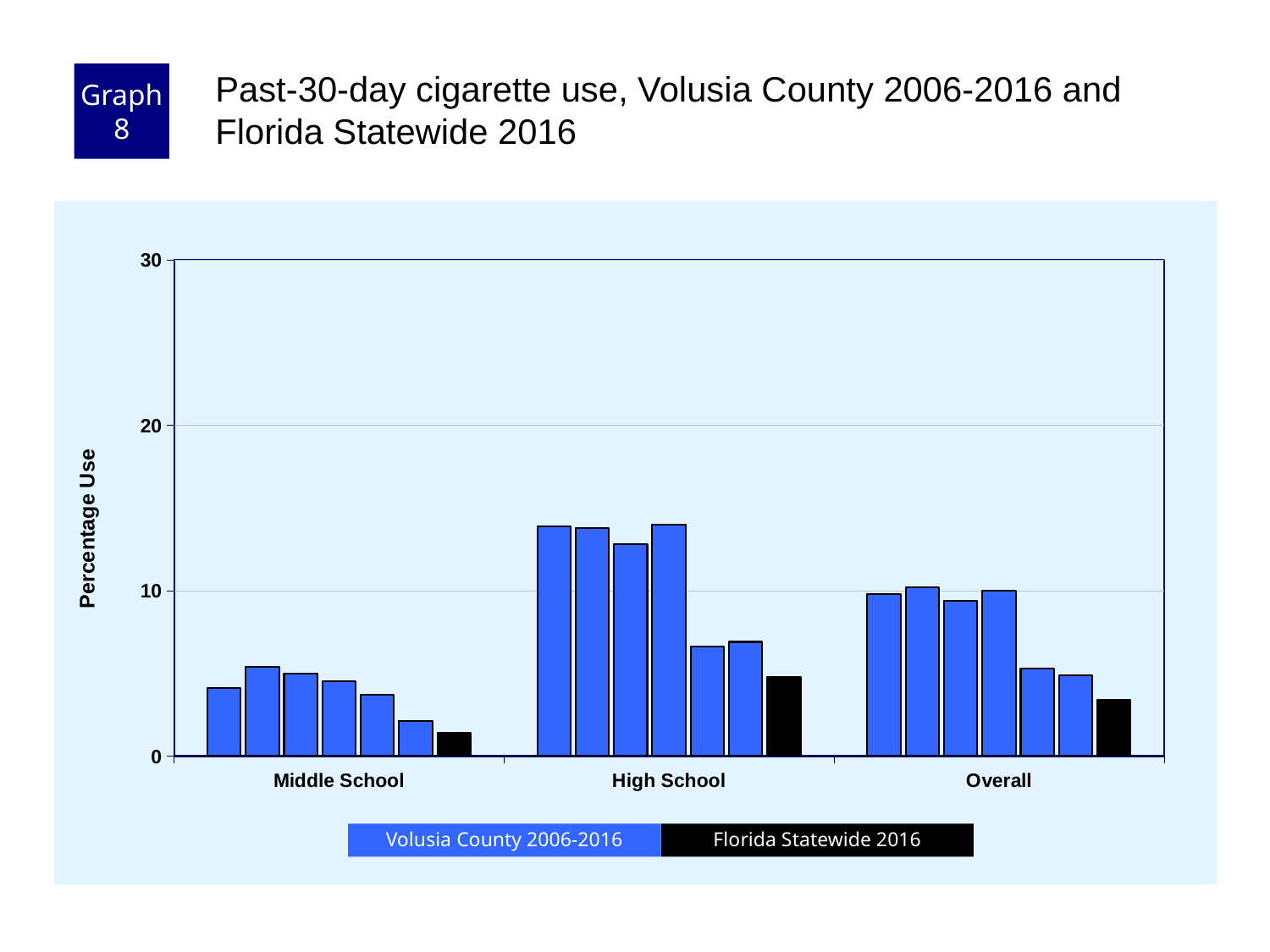
Is the Florida Statewide 2016 value for Middle School greater or less than 10? less Do the Volusia County 2006-2016 bars for High School generally rise or fall from left to right? fall What is the label on the y axis? Percentage Use Is the Florida Statewide 2016 value for High School greater or less than 10? less Is the Florida Statewide 2016 value for Overall greater or less than 10? less Which category has the highest bars in the chart? High School What kind of chart is shown on the slide? Bar chart Which is larger, the Florida Statewide 2016 value for High School or for Middle School? High School Which category has the lowest bars in the chart? Middle School How many school-level categories are shown on the x axis? 3 How many series does the legend list? 2